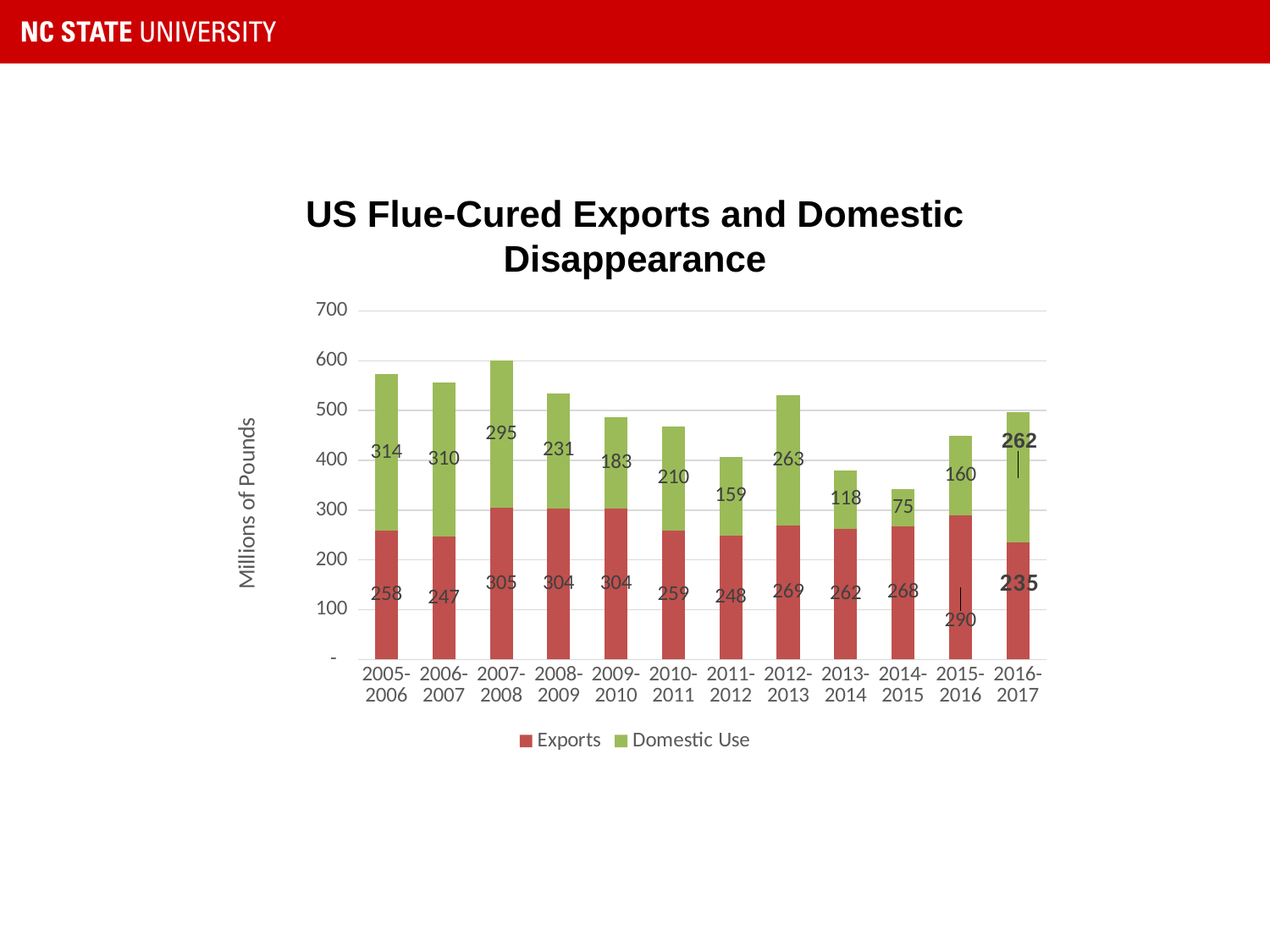
What is the difference between Domestic Use in 2005-2006 and Domestic Use in 2014-2015? 239 What is the Domestic Use value for 2016-2017? 262 How many series does the legend list? 2 Which year has the highest Domestic Use value? 2005-2006 How many crop years are shown on the x axis? 12 What is the total of the stacked bar for 2007-2008? 600 What type of chart is shown on the slide? Stacked bar chart What is the Domestic Use value for 2014-2015? 75 What is the Exports value for 2007-2008? 305 Is the Exports value for 2015-2016 larger than the Domestic Use value for 2015-2016? Yes, Exports (290) Which year has the lowest Exports value? 2016-2017 Which year has the lowest Domestic Use value? 2014-2015